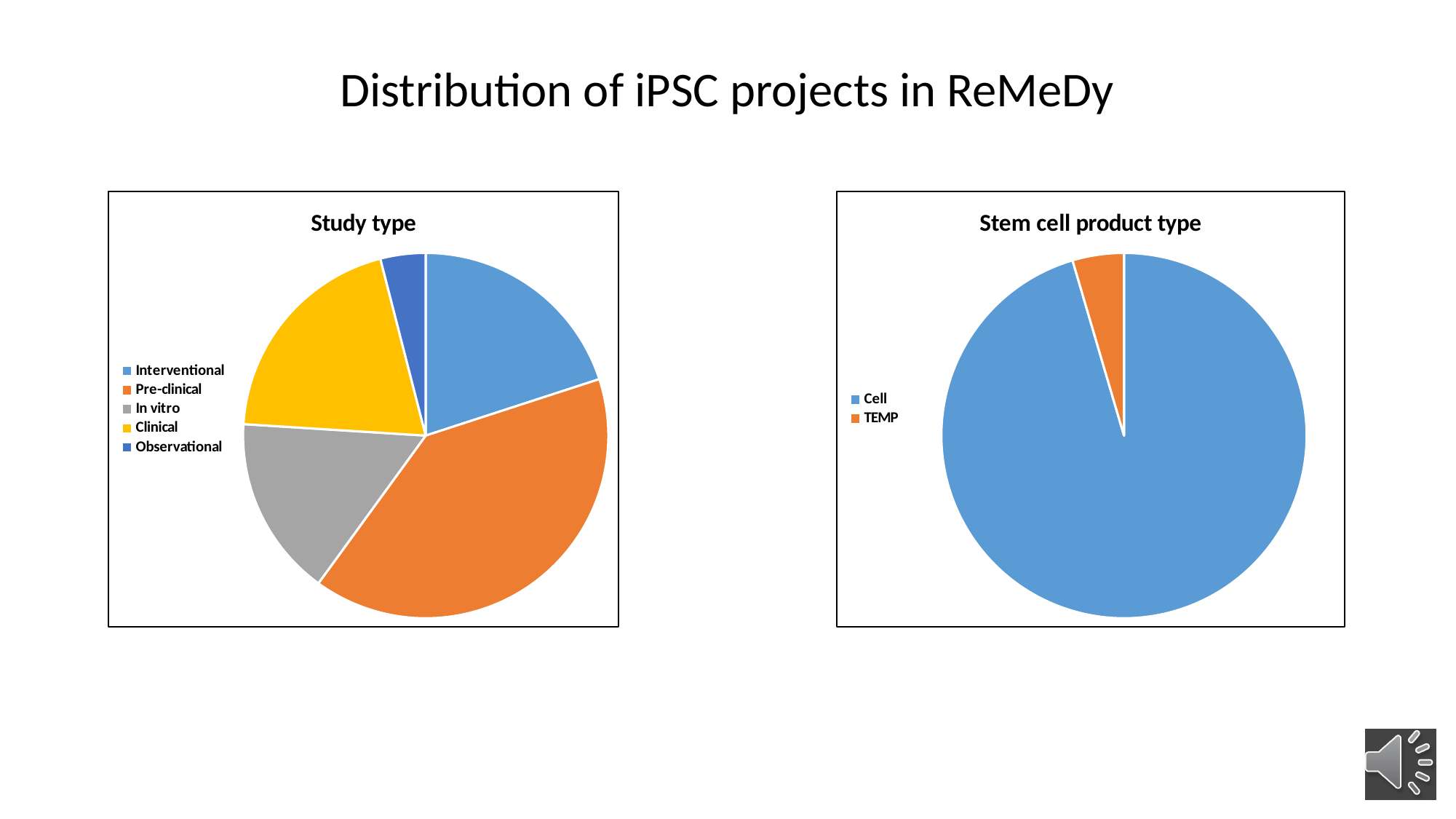
In the "Stem cell product type" chart, how many categories does the legend list? 2 In the "Study type" chart, which slice is larger, Clinical or Observational? Clinical In the "Study type" chart, which category has the smallest slice? Observational In the "Study type" chart, which slice is larger, Pre-clinical or Interventional? Pre-clinical In the "Stem cell product type" chart, what kind of chart is shown? pie chart In the "Study type" chart, what colour is the In vitro slice? grey In the "Stem cell product type" chart, which category has the largest slice? Cell What is the title of the chart on the right side of the slide? Stem cell product type In the "Study type" chart, what kind of chart is shown? pie chart In the "Stem cell product type" chart, which category has the smallest slice? TEMP In the "Study type" chart, how many categories does the legend list? 5 In the "Study type" chart, which category has the largest slice? Pre-clinical